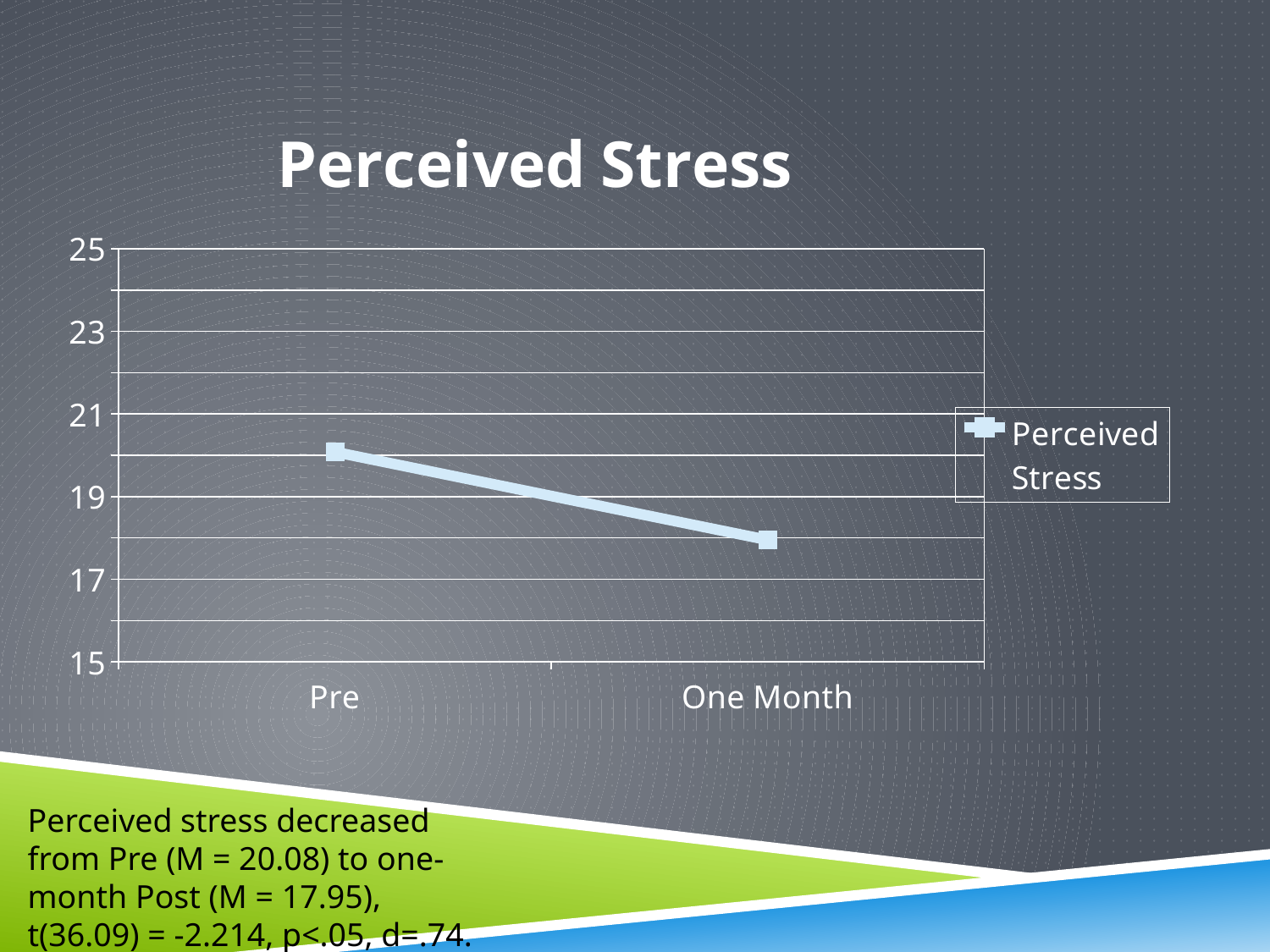
What are the two categories on the x axis? Pre and One Month Is the value for Pre greater or less than 19? greater What kind of chart is shown on the slide? line chart According to the slide, what is the mean perceived stress at one-month Post? 17.95 Is the value for One Month greater or less than 19? less Does perceived stress rise or fall from Pre to One Month? fall According to the slide, what is the mean perceived stress at Pre? 20.08 How many series does the legend list? 1 What is the title of the chart? Perceived Stress How many points are plotted along the x axis? 2 Which time point has the higher perceived stress value, Pre or One Month? Pre Which category has the lowest perceived stress value? One Month